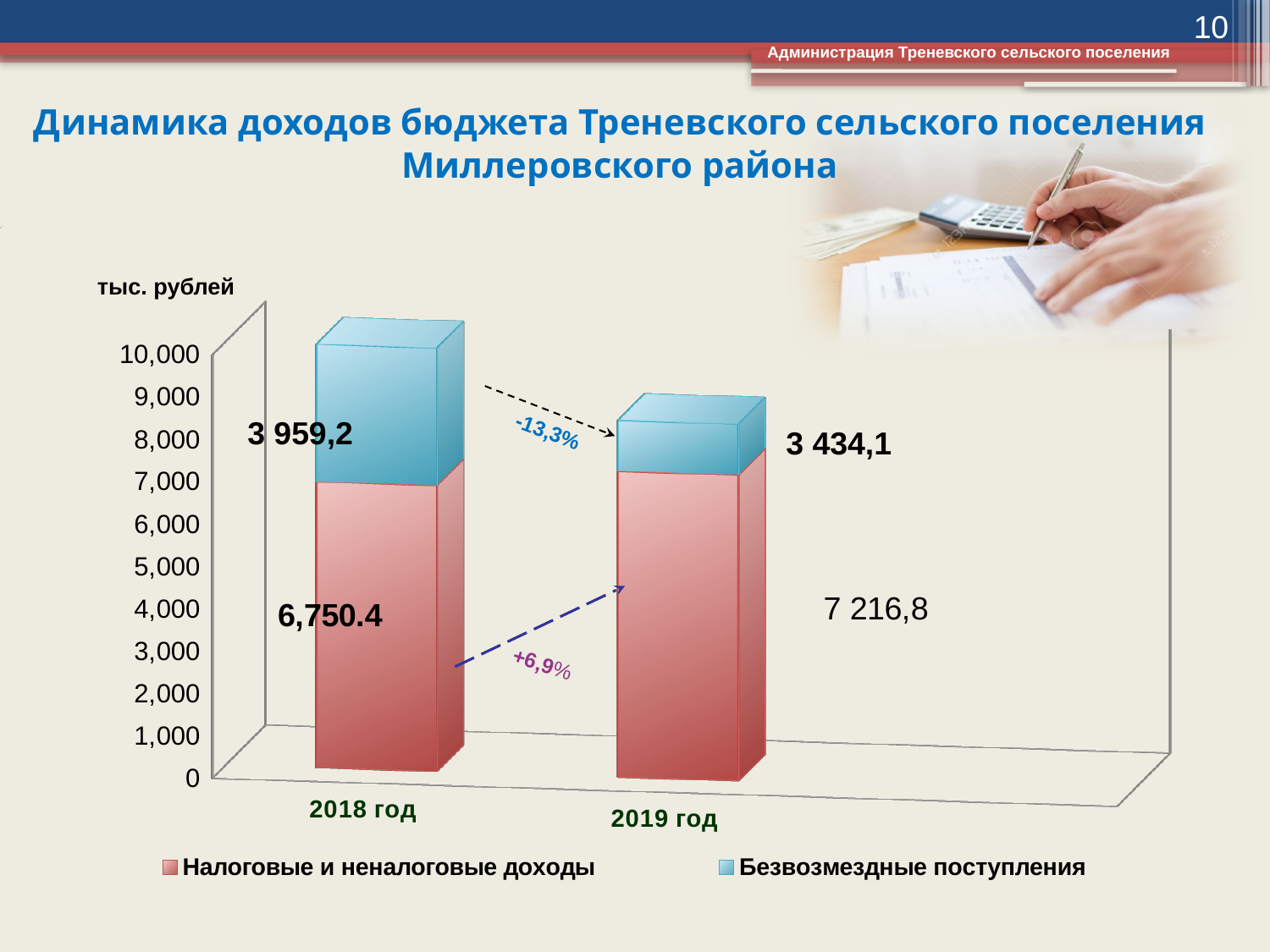
What unit is indicated above the vertical axis of the chart? тыс. рублей What is the value of Налоговые и неналоговые доходы for 2019 год? 7 216,8 What percentage change is shown on the chart for Безвозмездные поступления between 2018 and 2019? -13,3% What is the value of Безвозмездные поступления for 2019 год? 3 434,1 Do the values of Безвозмездные поступления rise or fall from 2018 год to 2019 год? Fall How many series does the chart legend list? 2 What kind of chart is shown on the slide? Stacked bar chart How many years (categories) are shown on the x axis of the chart? 2 What is the value of Налоговые и неналоговые доходы for 2018 год? 6,750.4 What is the value of Безвозмездные поступления for 2018 год? 3 959,2 In which year is the value of Налоговые и неналоговые доходы larger, 2018 год or 2019 год? 2019 год Which series has the larger value in 2019 год? Налоговые и неналоговые доходы